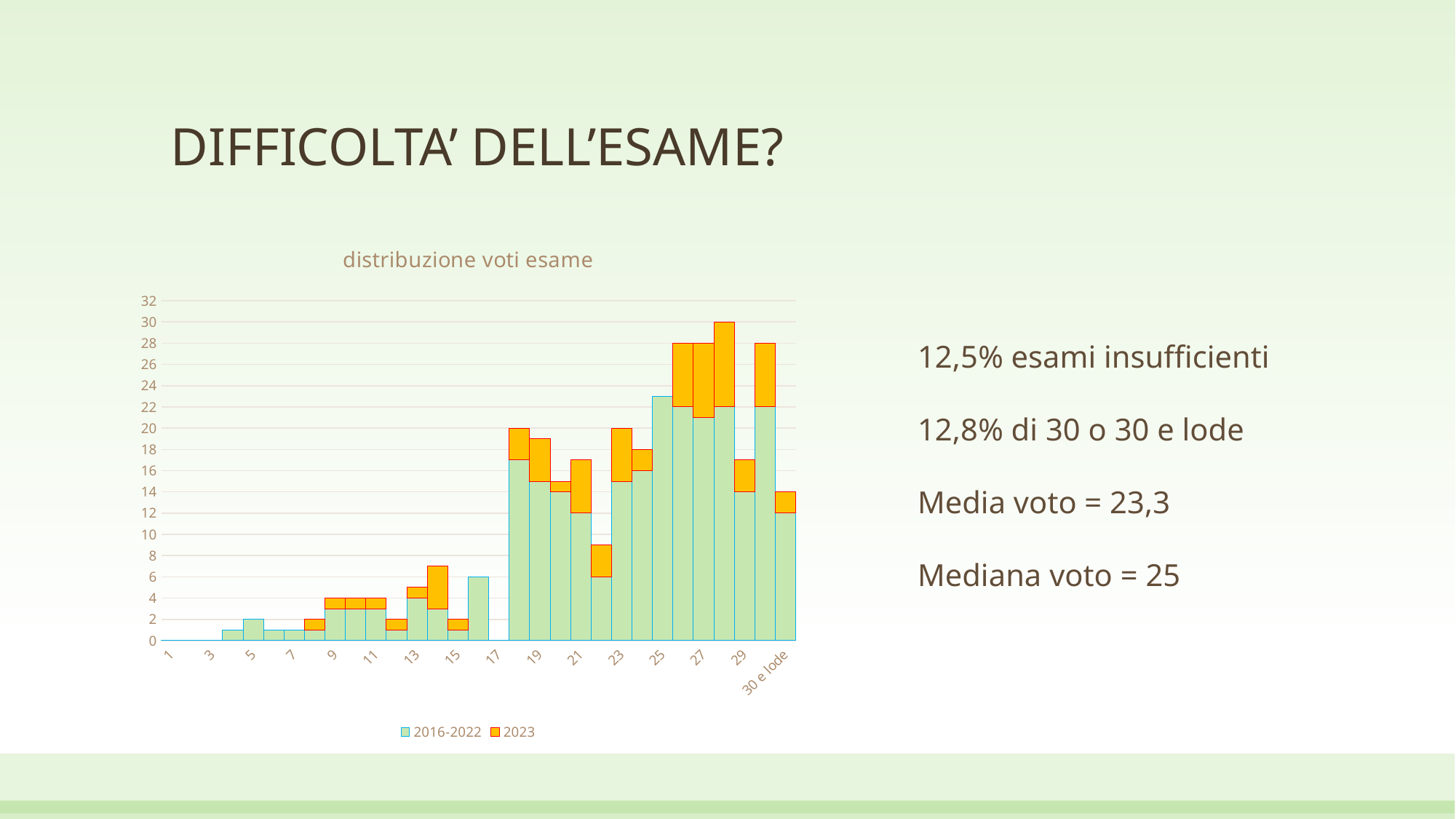
What are the two series named in the chart legend? 2016-2022 and 2023 Is the total bar height for grade 25 greater or less than 20? greater What kind of chart is shown on the slide? bar chart For the last bar, '30 e lode', which series contributes more: 2016-2022 or 2023? 2016-2022 What is the title of the chart? distribuzione voti esame Is the total bar height for grade 19 greater or less than 10? greater How many series does the legend of the chart list? 2 What is the highest total value reached by any stacked bar in the chart? 30 Is the total bar height for grade 5 greater or less than 4? less Which grade has the tallest stacked bar in the chart? 28 What is the total height of the stacked bar for '30 e lode'? 14